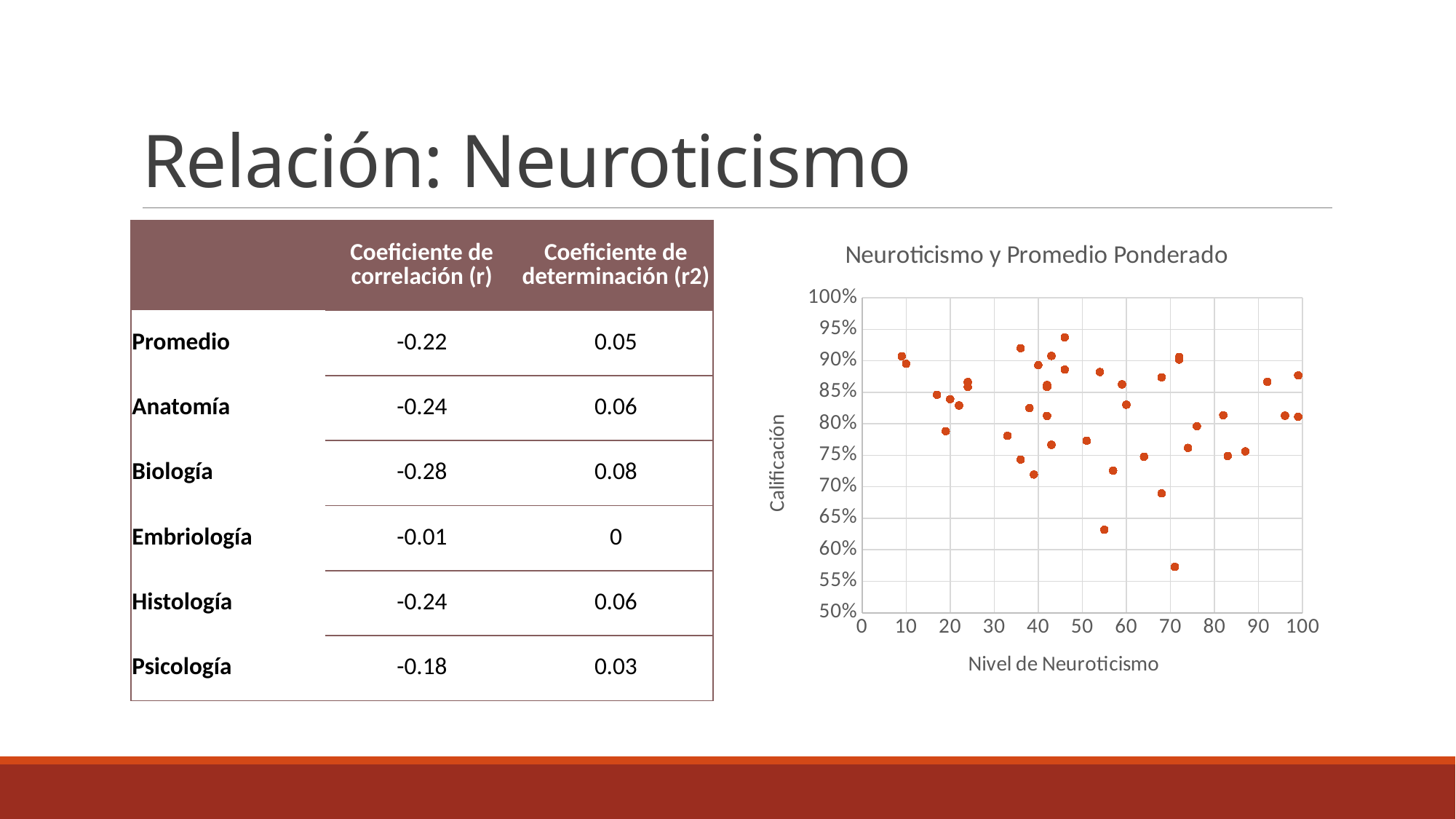
Is the Calificación of the highest point in the chart greater or less than 90%? greater Is the Calificación of the leftmost point in the chart (near Nivel de Neuroticismo 10) greater or less than 85%? greater Is the Nivel de Neuroticismo of the highest point in the chart greater or less than 60? less What is the title of the chart on the slide? Neuroticismo y Promedio Ponderado What kind of chart is shown on the slide? scatter chart What is the label of the x axis of the chart? Nivel de Neuroticismo